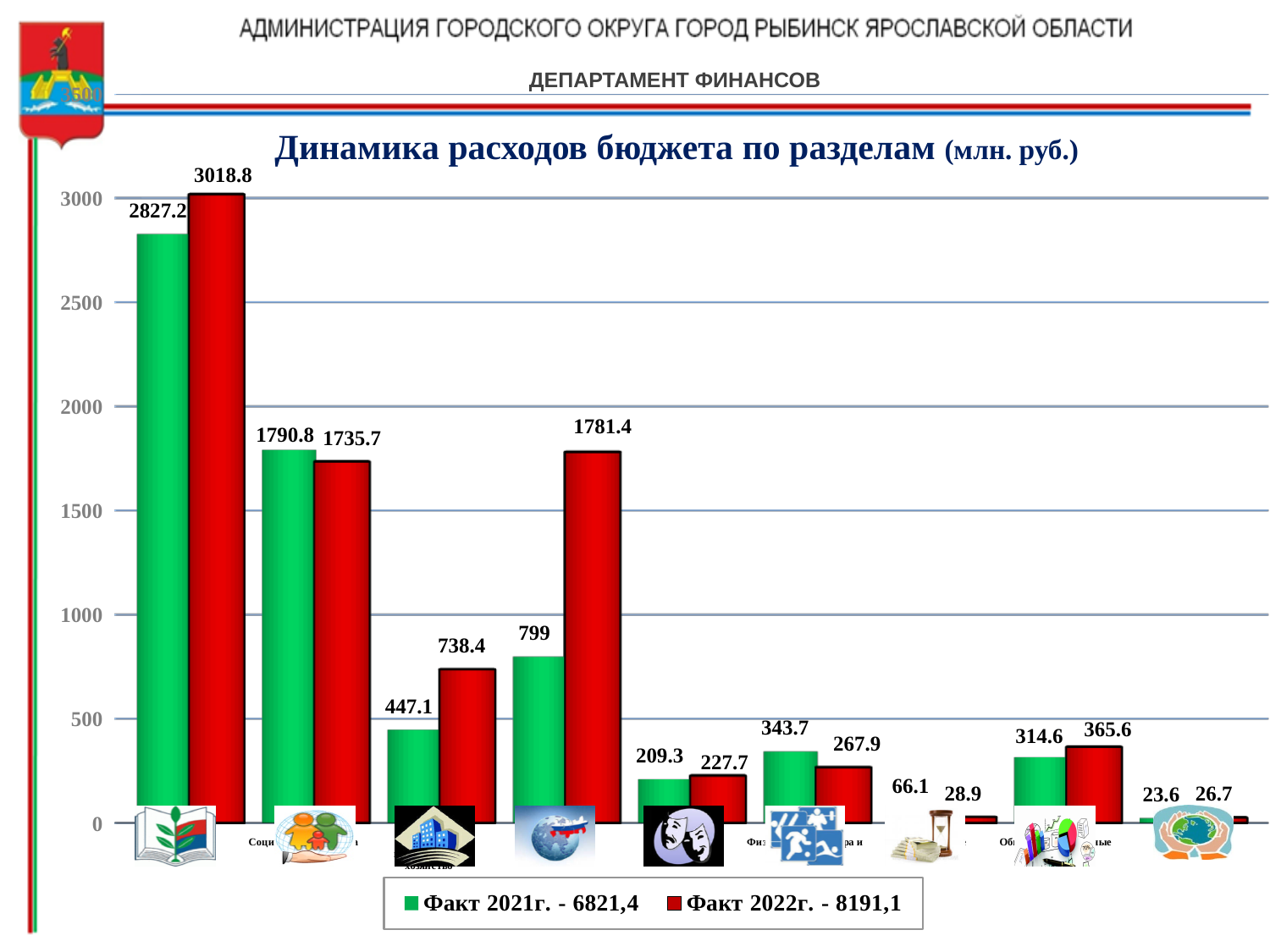
Which category group has the highest Факт 2022г. value? the first (leftmost) group, 3018.8 What colour are the Факт 2021г. bars? green In the second category group from the left, which is larger: the Факт 2021г. value or the Факт 2022г. value? Факт 2021г. (1790.8) Which category group has the lowest Факт 2021г. value? the last (rightmost) group, 23.6 What is the value of the Факт 2021г. bar in the first (leftmost) category group? 2827.2 What is the value of the Факт 2022г. bar in the first (leftmost) category group? 3018.8 How many category groups of bars are plotted in the chart? 9 What total is shown in the legend for Факт 2022г.? 8191,1 What kind of chart is shown on the slide? bar chart What is the value of the Факт 2022г. bar in the fourth category group from the left? 1781.4 What is the difference between the Факт 2022г. and Факт 2021г. values in the fourth category group from the left (1781.4 and 799)? 982.4 How many series does the legend list? 2